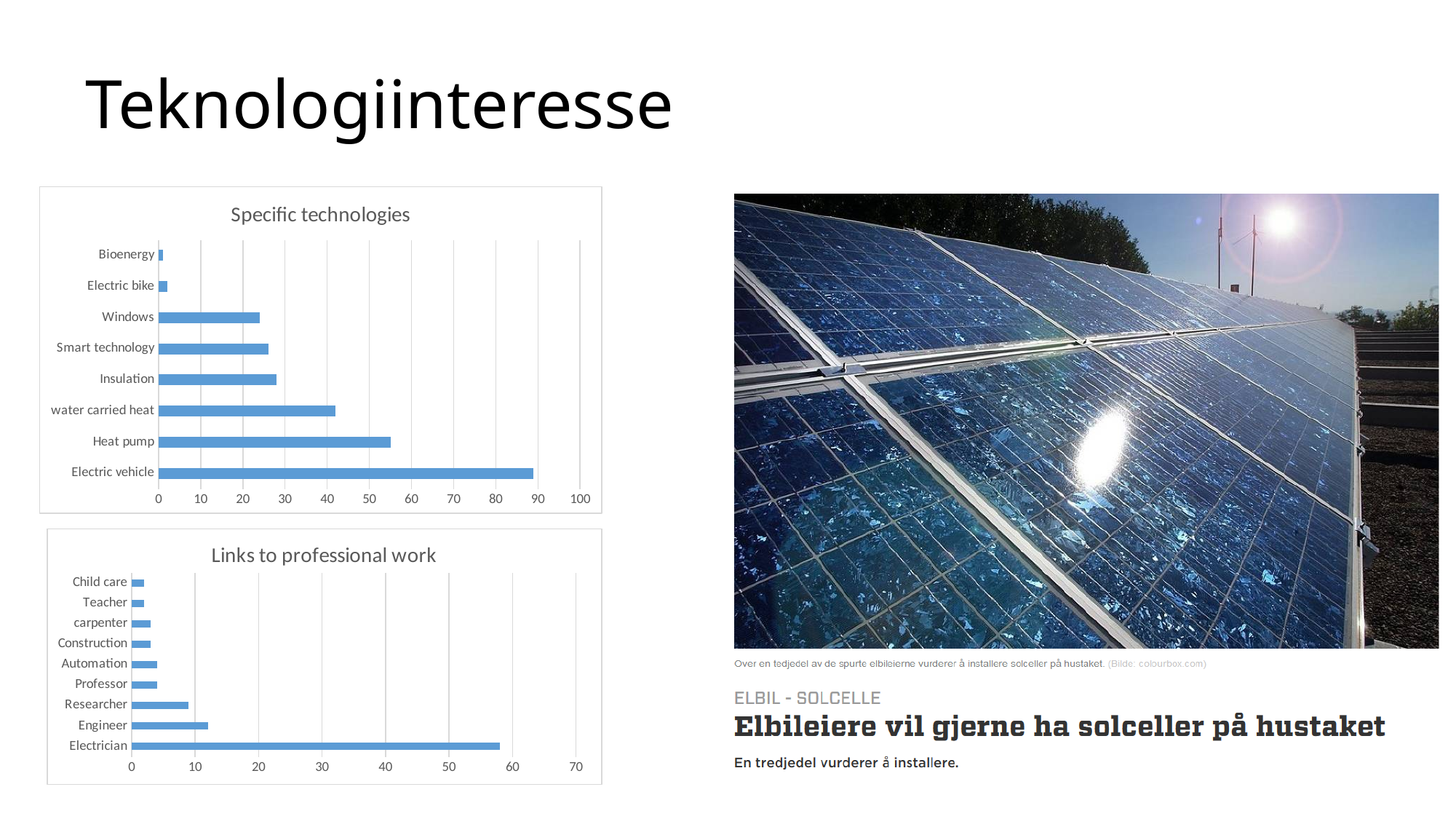
How many categories are shown in the 'Links to professional work' chart? 9 How many categories are shown in the 'Specific technologies' chart? 8 In the 'Specific technologies' chart, which is larger, Heat pump or Insulation? Heat pump In the 'Specific technologies' chart, is the value for water carried heat greater or less than 50? less In the 'Links to professional work' chart, is the value for Electrician greater or less than 50? greater In the 'Links to professional work' chart, is the value for Engineer greater or less than 20? less In the 'Specific technologies' chart, which category has the highest value? Electric vehicle What kind of chart is 'Specific technologies'? Bar chart What is the title of the lower chart on the slide? Links to professional work In the 'Links to professional work' chart, which category has the highest value? Electrician